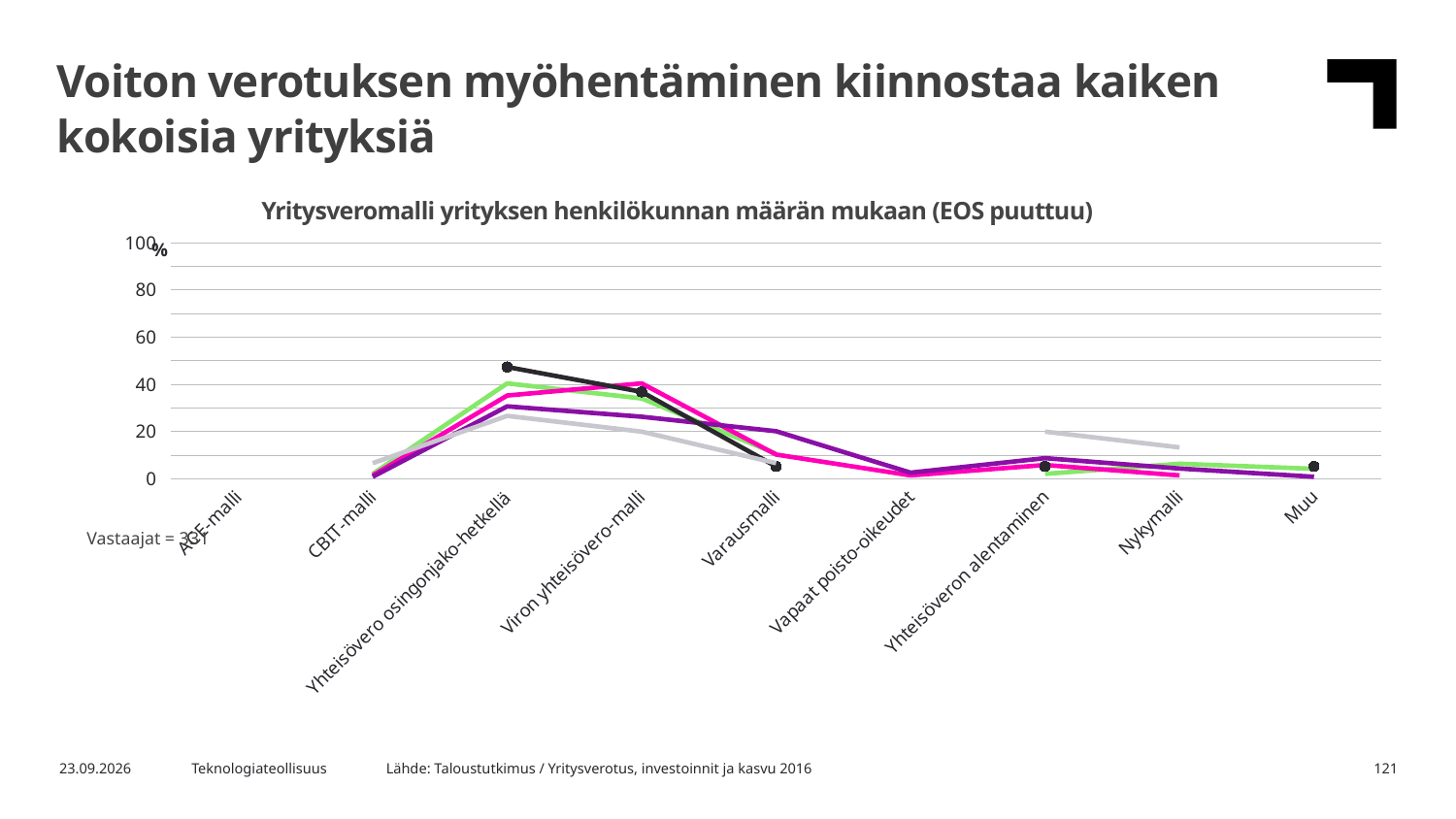
What kind of chart is shown on the slide? line chart Are all the values at Nykymalli greater or less than 20? less Which category has the highest plotted value in the chart? Yhteisövero osingonjako-hetkellä Is the highest value at Muu greater or less than 20? less Are all the values at Vapaat poisto-oikeudet greater or less than 20? less Do the values rise or fall from Viron yhteisövero-malli to Vapaat poisto-oikeudet? fall How many categories are shown on the x axis of the chart? 9 Do the values rise or fall from CBIT-malli to Yhteisövero osingonjako-hetkellä? rise What is the title of the chart? Yritysveromalli yrityksen henkilökunnan määrän mukaan (EOS puuttuu)